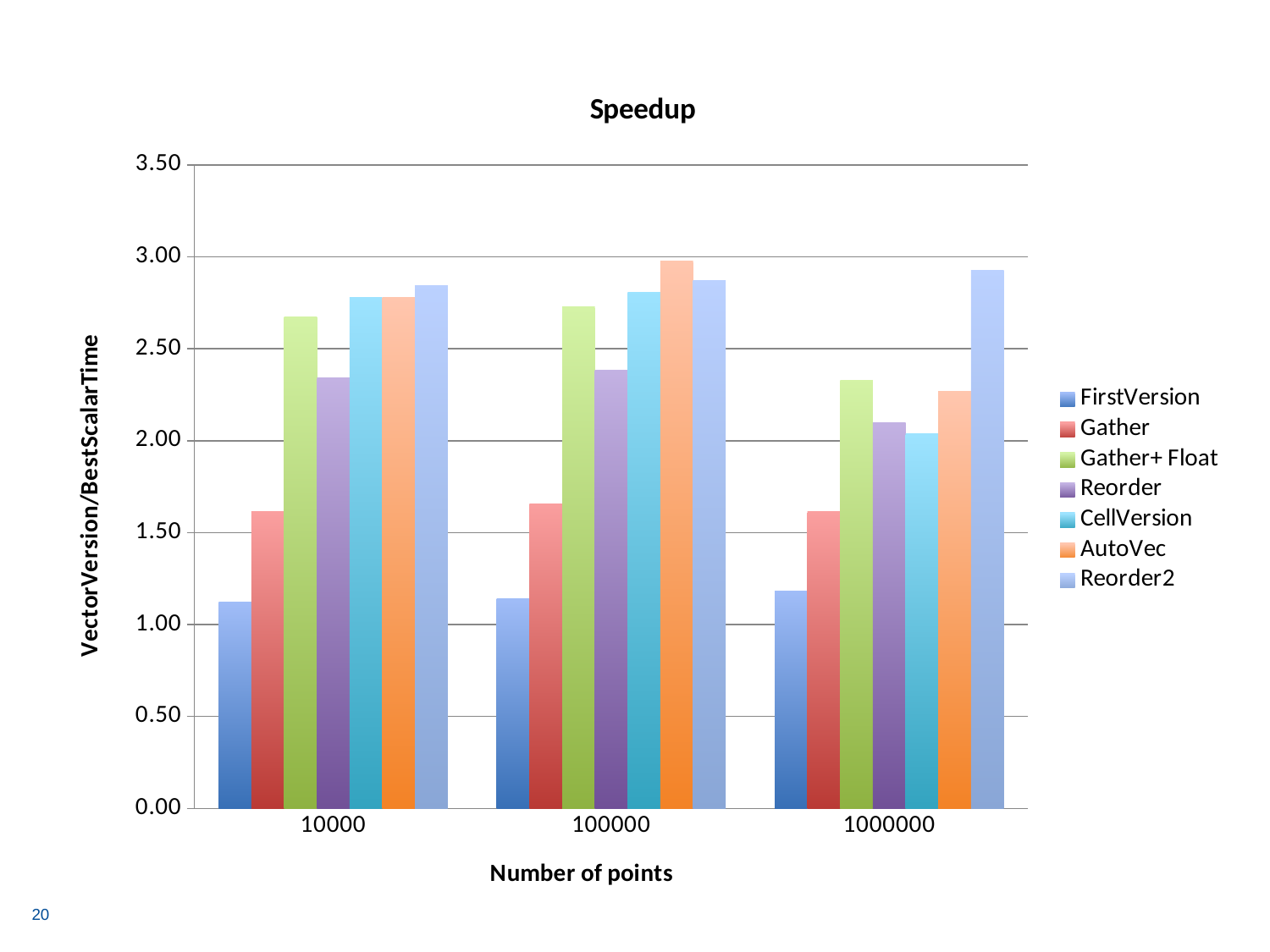
How many series does the legend list? 7 Which series has the highest value for 1000000 points? Reorder2 At 10000 points, which is larger: Gather+ Float or Reorder? Gather+ Float Is the value for Gather+ Float at 10000 points greater or less than 2.50? greater Which series has the lowest value for 10000 points? FirstVersion What is the label of the y axis? VectorVersion/BestScalarTime What kind of chart is shown on the slide? bar chart How many categories are shown on the x axis? 3 Is the value for Gather at 100000 points greater or less than 1.50? greater Is the value for CellVersion at 1000000 points greater or less than 2.50? less Which series has the highest value for 100000 points? AutoVec